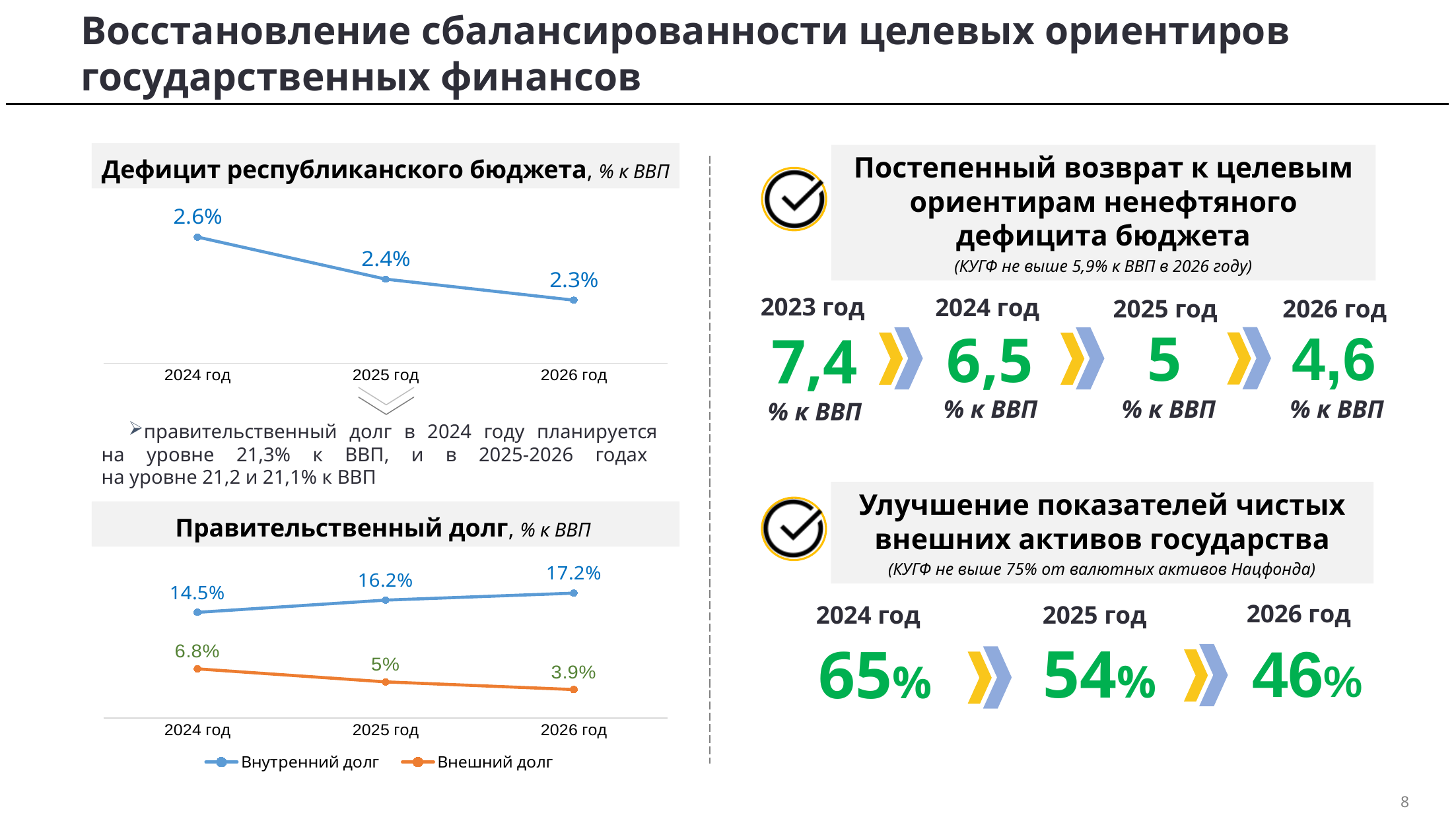
In the chart titled "Правительственный долг, % к ВВП", what is the value of Внутренний долг for 2025 год? 16.2% In the chart titled "Дефицит республиканского бюджета, % к ВВП", what is the value for 2024 год? 2.6% In the chart titled "Дефицит республиканского бюджета, % к ВВП", how many data points are plotted? 3 In the chart titled "Дефицит республиканского бюджета, % к ВВП", do the values rise or fall from 2024 год to 2026 год? fall In the chart titled "Правительственный долг, % к ВВП", how many series does the legend list? 2 In the chart titled "Правительственный долг, % к ВВП", which series is higher in 2026 год, Внутренний долг or Внешний долг? Внутренний долг What kind of chart is the one titled "Дефицит республиканского бюджета, % к ВВП"? line chart In the chart titled "Правительственный долг, % к ВВП", what is the difference between Внутренний долг and Внешний долг in 2024 год? 7.7% In the chart titled "Дефицит республиканского бюджета, % к ВВП", what is the value for 2026 год? 2.3% In the chart titled "Правительственный долг, % к ВВП", what is the value of Внешний долг for 2026 год? 3.9% In the chart titled "Правительственный долг, % к ВВП", what colour is the line for Внешний долг? orange In the chart titled "Правительственный долг, % к ВВП", in which year is Внешний долг lowest? 2026 год